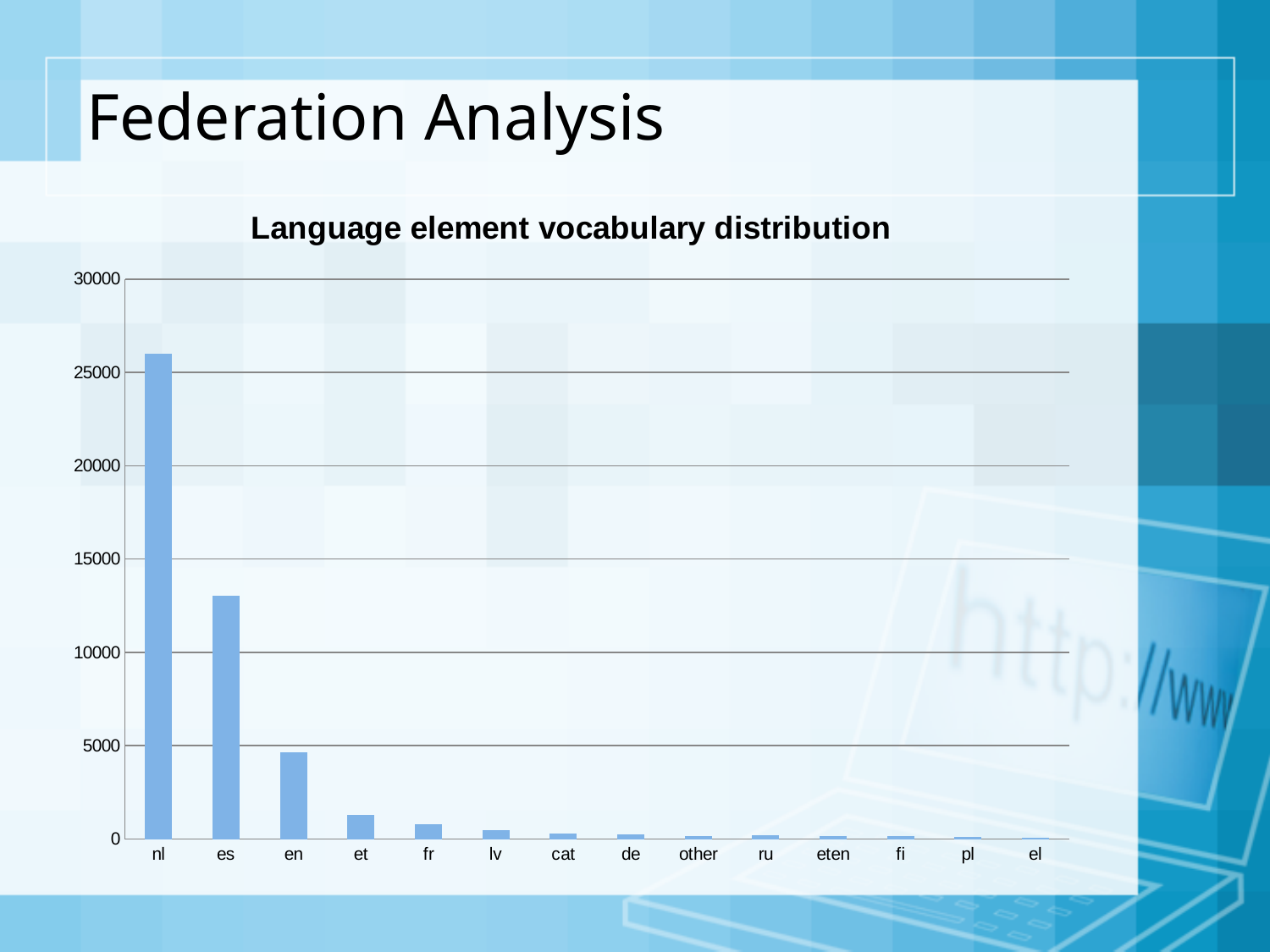
Which has a larger value, nl or es? nl Is the value for en greater or less than 5000? less Is the value for es greater or less than 15000? less Is the value for nl greater or less than 25000? greater Which category is listed first on the x axis? nl Which has a larger value, en or et? en How many language categories are shown on the x axis? 14 What kind of chart is shown on the slide? bar chart Do the values rise or fall moving from left to right along the x axis? fall Which language has the highest vocabulary count? nl What is the title of the chart? Language element vocabulary distribution